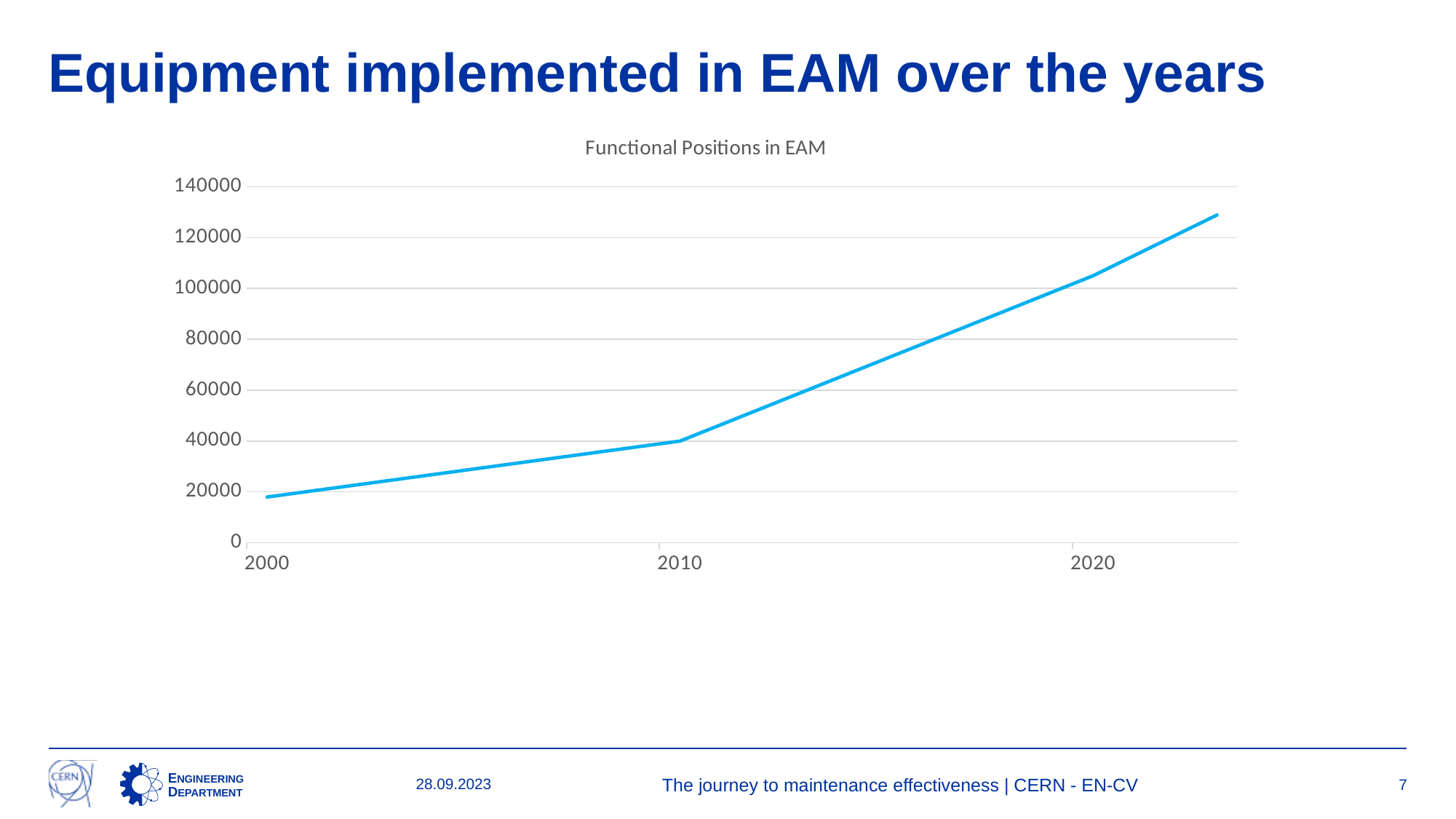
Which of the labelled years on the x axis has the lowest value? 2000 Is the value for 2000 greater or less than 40000? less Do the values in the chart rise or fall from 2000 to 2020? rise Is the value for 2020 greater or less than 100000? greater What is the highest value shown on the y axis? 140000 Is the value for 2010 greater or less than 20000? greater What is the title of the chart? Functional Positions in EAM Which year has the higher value, 2000 or 2020? 2020 What kind of chart is shown on the slide? line chart